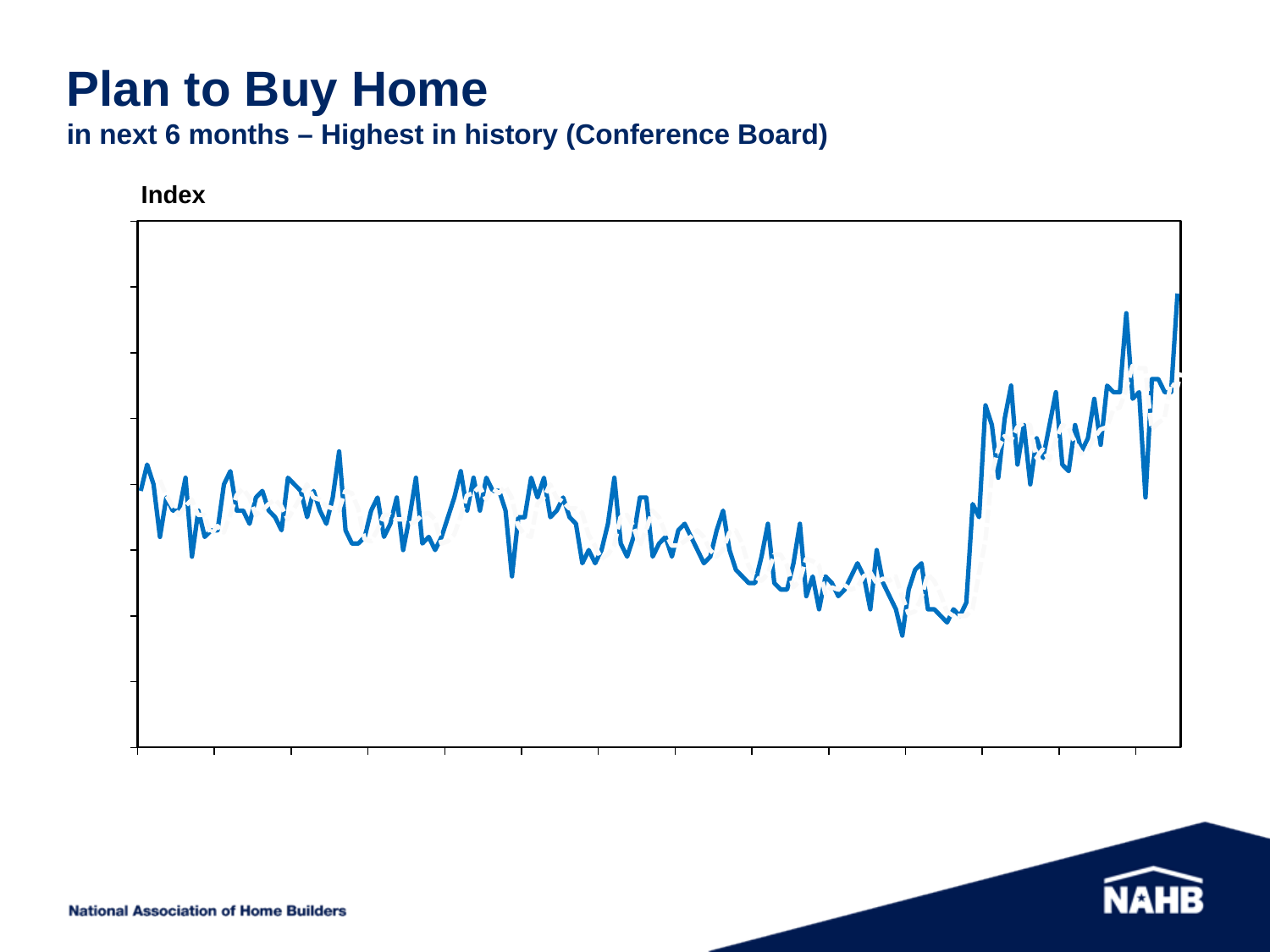
What kind of chart is shown on the slide? line chart Does the line end higher or lower than it starts at the left of the chart? higher Is the lowest point of the line in the first half or the second half of the chart? second half What is the title of the chart on the slide? Plan to Buy Home Does the line reach its highest value near the beginning or near the end of the series? near the end What label is shown on the vertical axis of the chart? Index Over the final portion of the chart, does the line rise or fall sharply compared with the middle section? rise